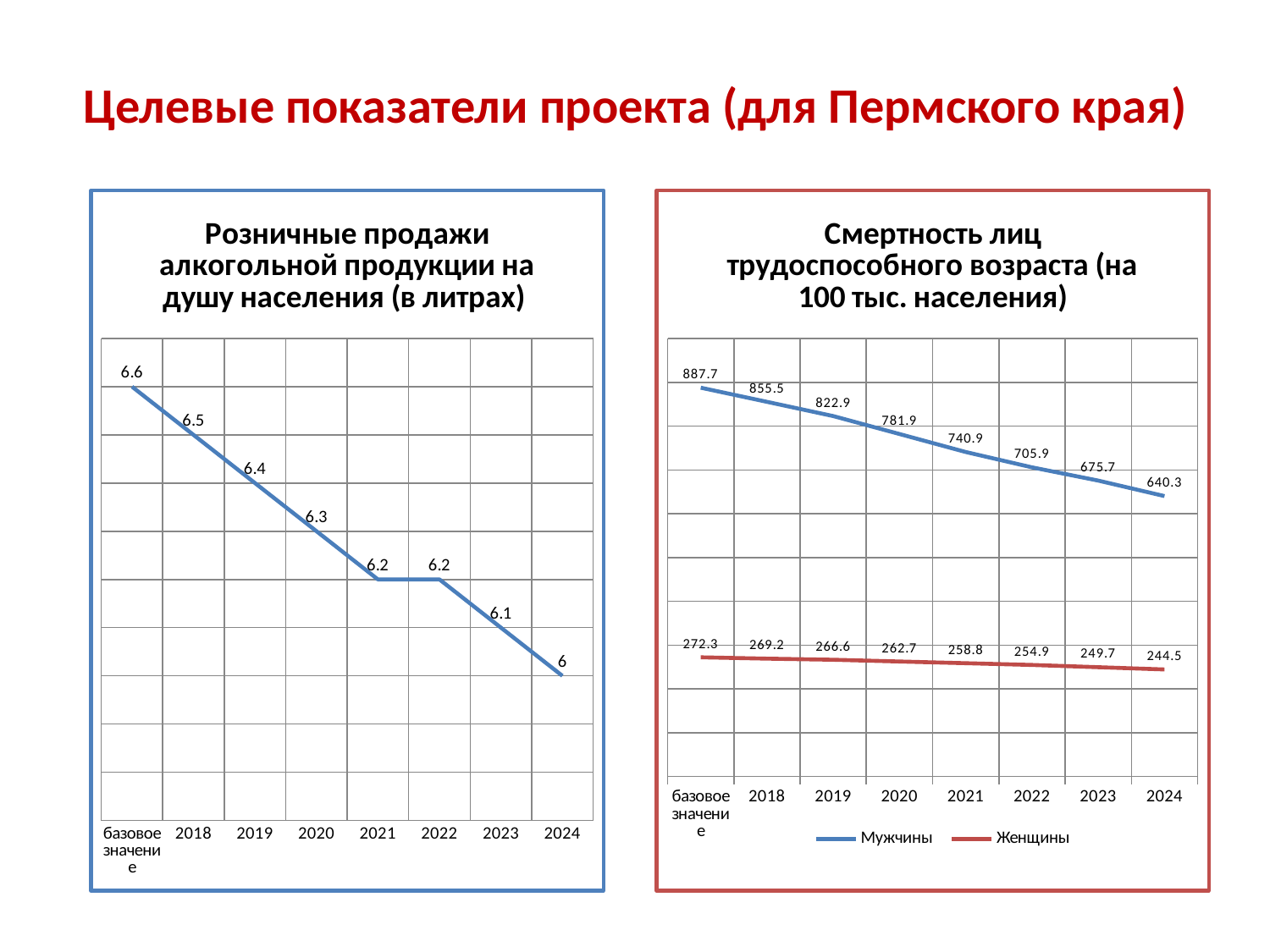
In the right chart (Смертность лиц трудоспособного возраста), what is the value for Женщины in 2024? 244.5 In the left chart (Розничные продажи алкогольной продукции на душу населения), what is the value for базовое значение? 6.6 In the right chart (Смертность лиц трудоспособного возраста), how many series does the legend list? 2 What kind of chart is the right chart (Смертность лиц трудоспособного возраста)? line chart In the left chart (Розничные продажи алкогольной продукции на душу населения), do the values rise or fall from базовое значение to 2024? fall In the right chart (Смертность лиц трудоспособного возраста), which series has the higher value in 2022, Мужчины or Женщины? Мужчины In the left chart (Розничные продажи алкогольной продукции на душу населения), how many categories are on the x axis? 8 In the right chart (Смертность лиц трудоспособного возраста), what is the difference between the Мужчины and Женщины values in 2018? 586.3 In the left chart (Розничные продажи алкогольной продукции на душу населения), what is the difference between the базовое значение and the 2024 value? 0.6 In the left chart (Розничные продажи алкогольной продукции на душу населения), what is the value for 2020? 6.3 In the left chart (Розничные продажи алкогольной продукции на душу населения), which category has the lowest value? 2024 In the right chart (Смертность лиц трудоспособного возраста), what is the value for Мужчины in 2021? 740.9